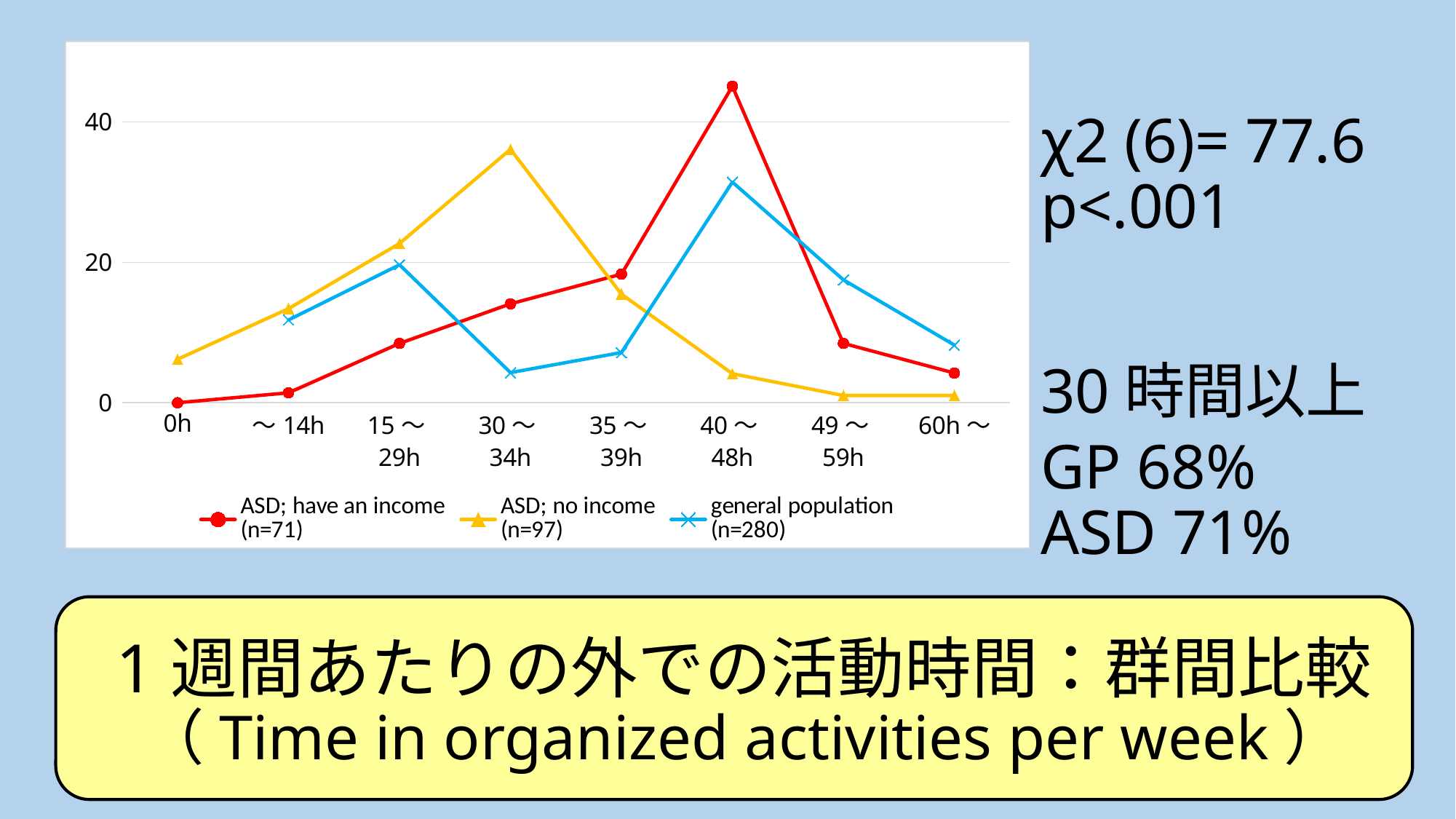
For which category is the value for 'general population (n=280)' highest? 40～48h Is the value for 'ASD; have an income (n=71)' at 40～48h greater or less than 40? greater Is the value for 'ASD; no income (n=97)' at 30～34h greater or less than 20? greater What is the sample size (n) given in the legend for the 'general population' series? n=280 For which category is the value for 'ASD; have an income (n=71)' highest? 40～48h What kind of chart is shown on the slide? line chart At 40～48h, which series has the larger value: 'ASD; have an income (n=71)' or 'general population (n=280)'? ASD; have an income (n=71) At 30～34h, which series has the larger value: 'ASD; no income (n=97)' or 'ASD; have an income (n=71)'? ASD; no income (n=97) How many categories are shown along the x axis? 8 For which category is the value for 'ASD; no income (n=97)' highest? 30～34h How many series does the legend list? 3 Is the value for 'general population (n=280)' at 30～34h greater or less than 20? less